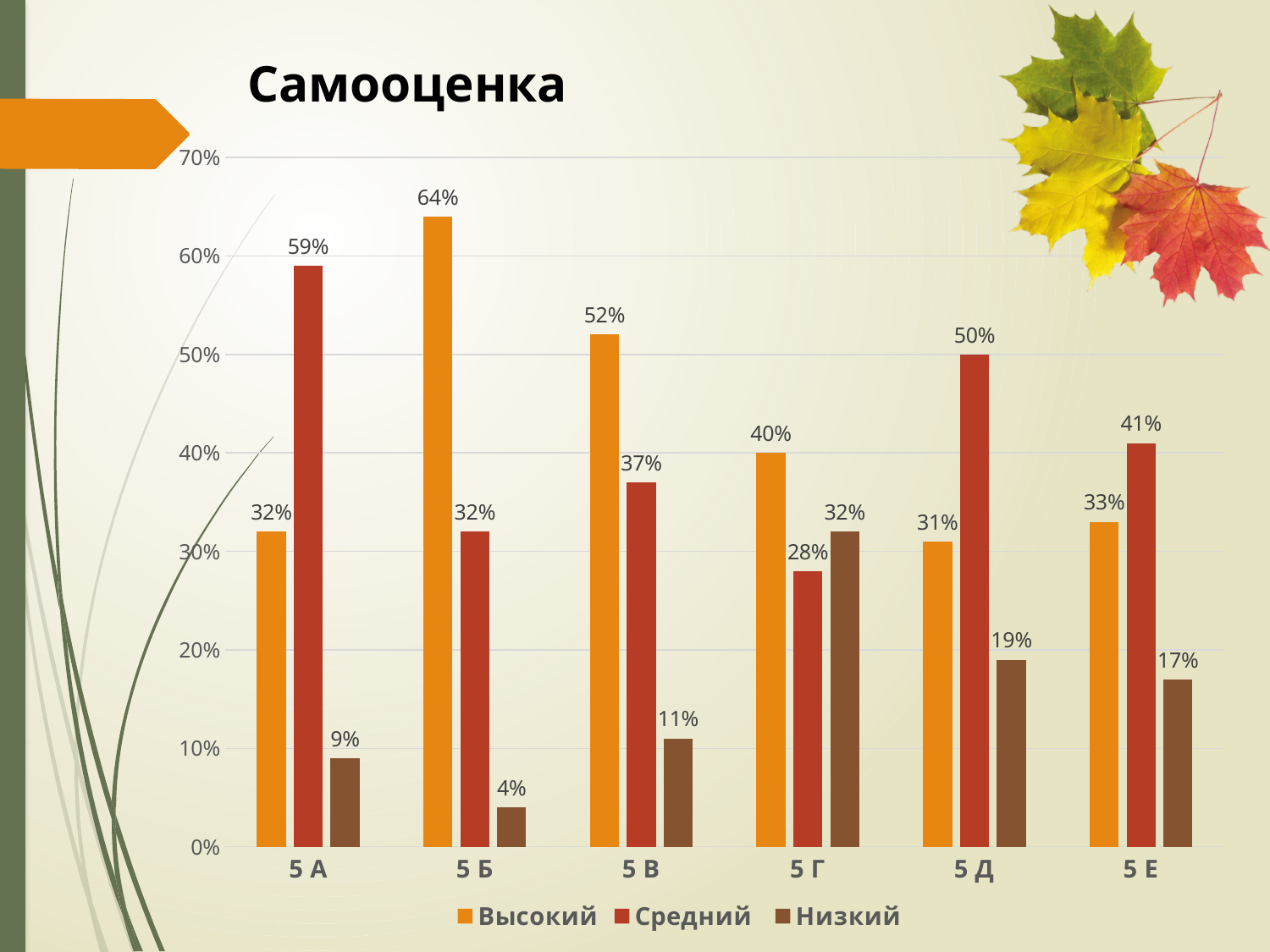
Which is larger for 5 Д: Высокий or Средний? Средний Which category has the lowest value for Низкий? 5 Б How many categories are shown on the x axis? 6 How many series does the legend list? 3 What is the value of Низкий for 5 Г? 32% What is the difference between Высокий and Средний for 5 В? 15% What type of chart is shown on the slide? bar chart What is the value of Средний for 5 А? 59% Is the value of Средний for 5 Е greater or less than 40%? greater Which category has the highest value for Низкий? 5 Г What is the value of Высокий for 5 Б? 64% Which category has the highest value for Высокий? 5 Б